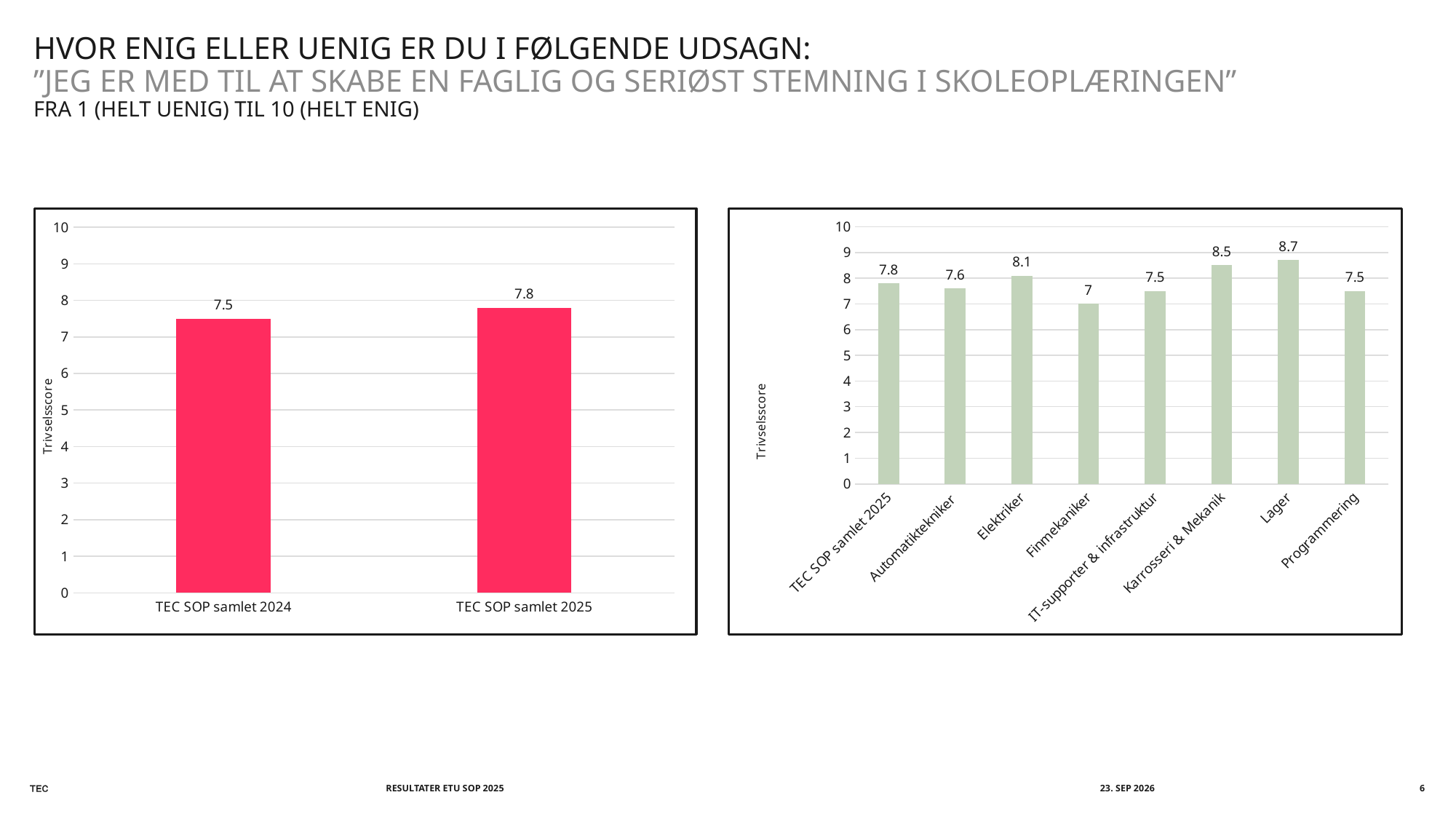
In the left chart, how many bars are plotted? 2 In the right chart, which category has the lowest value? Finmekaniker In the right chart, how many categories are shown on the x axis? 8 In the right chart, what is the value for Lager? 8.7 What type of chart is the right chart? Bar chart In the right chart, what is the difference between Karrosseri & Mekanik and Programmering? 1 In the right chart, which is larger: Elektriker or Automatiktekniker? Elektriker In the right chart, which category has the highest value? Lager In the left chart, what is the value for TEC SOP samlet 2025? 7.8 In the left chart, what is the value for TEC SOP samlet 2024? 7.5 In the right chart, what is the value for Finmekaniker? 7 In the left chart, what is the difference between TEC SOP samlet 2025 and TEC SOP samlet 2024? 0.3